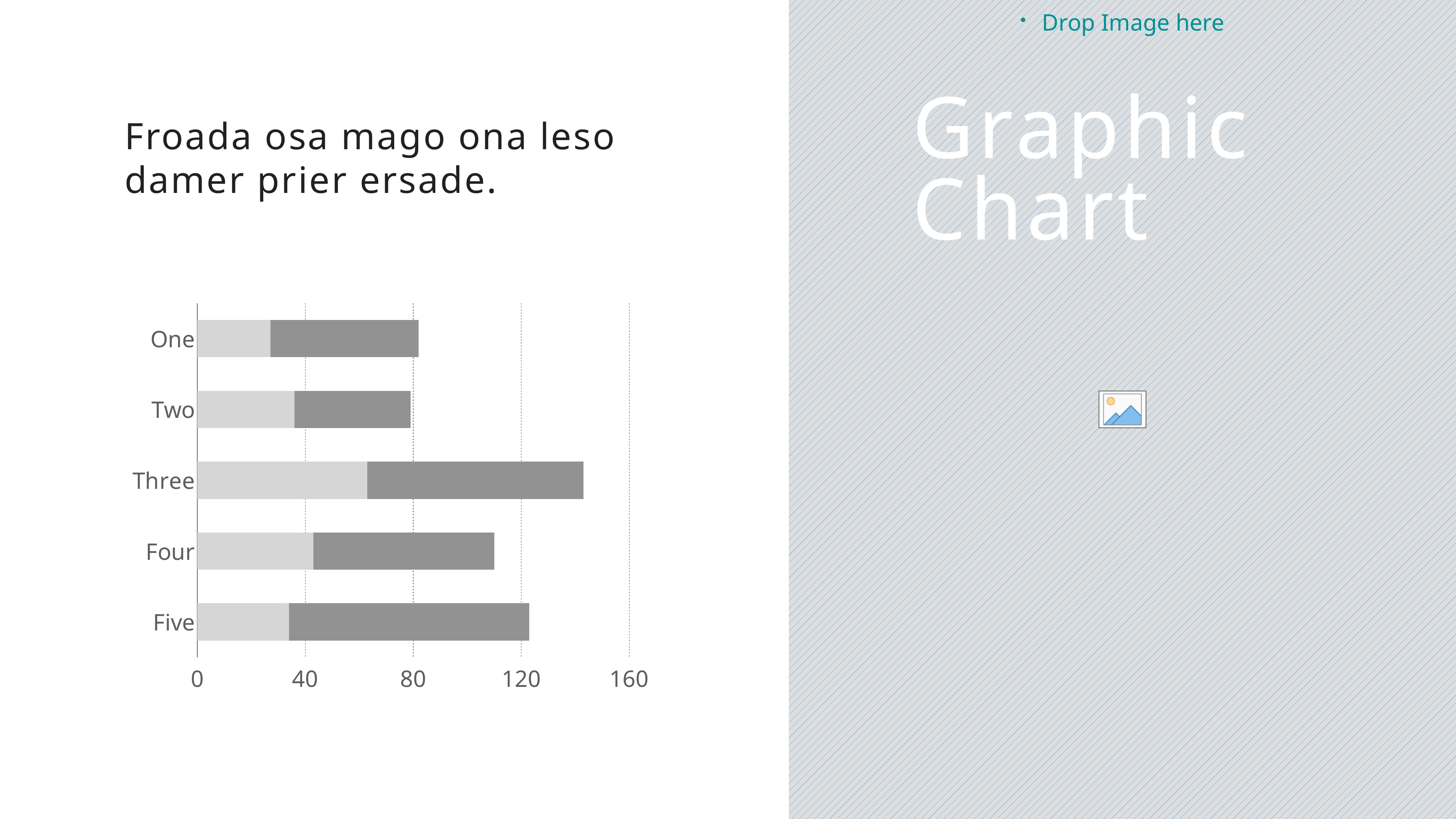
Which category has the longest bar? Three Is the total value for Five greater or less than 80? greater Which has the longer bar, Five or One? Five What kind of chart is shown on the slide? bar chart Is the total value for Three greater or less than 120? greater How many stacked segments does each bar have? 2 Which has the longer bar, Three or Four? Three What is the highest value shown on the horizontal axis? 160 Is the total value for Four greater or less than 80? greater How many categories are shown on the chart? 5